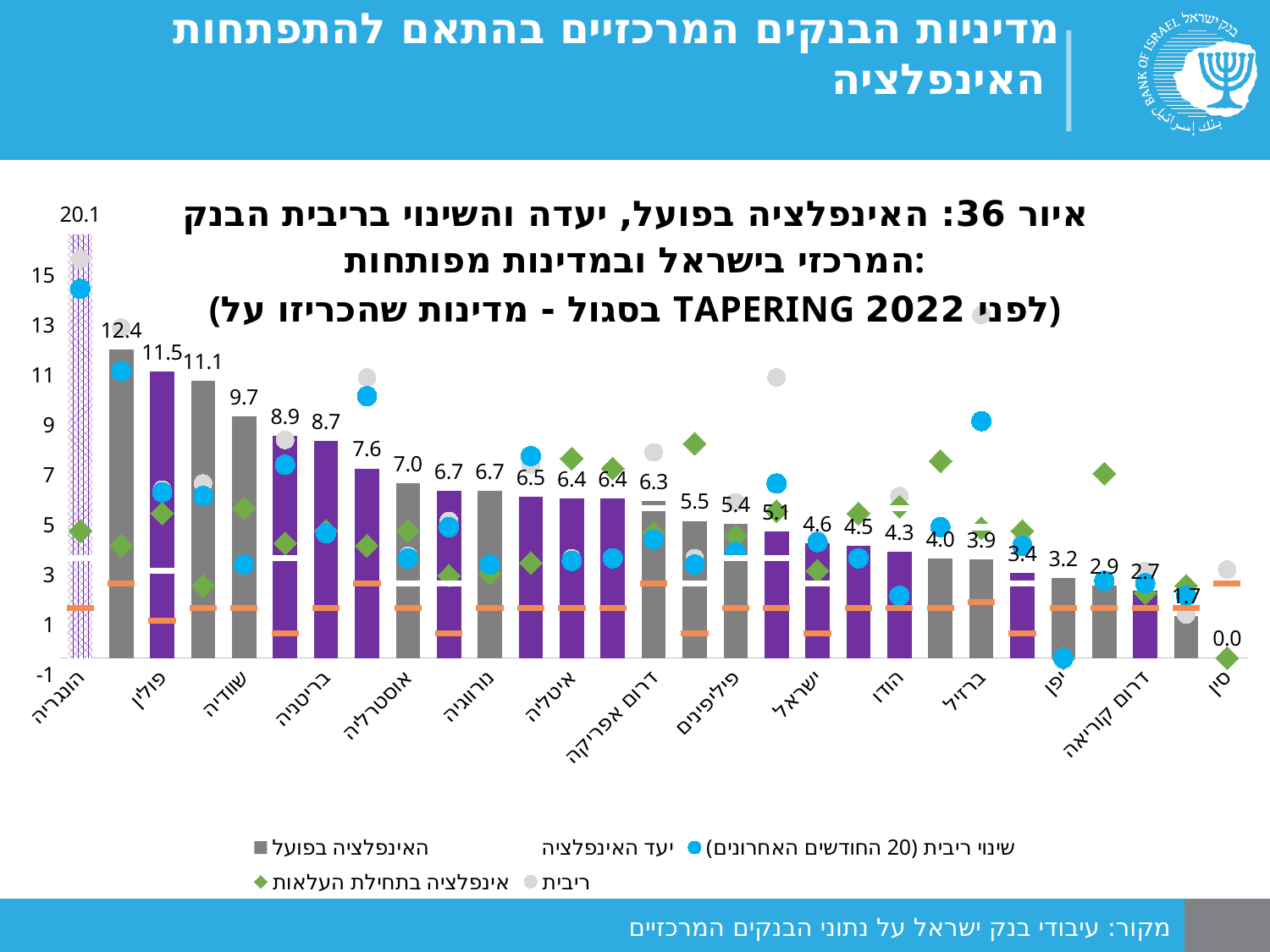
Which has a higher actual inflation value, פולין or שוודיה? פולין What is the actual inflation value shown for הונגריה? 20.1 What is the actual inflation value shown for יפן? 3.2 What is the actual inflation value shown for סין? 0.0 Do the actual inflation bars rise or fall moving from left to right across the chart? fall What is the figure number given in the chart title? 36 What is the difference between the actual inflation values for הונגריה and ישראל? 15.5 Which country has the highest actual inflation bar in the chart? הונגריה What is the actual inflation value shown for ישראל? 4.6 How many series does the legend list? 5 Which country has the lowest actual inflation bar in the chart? סין What type of chart is shown on the slide? bar chart